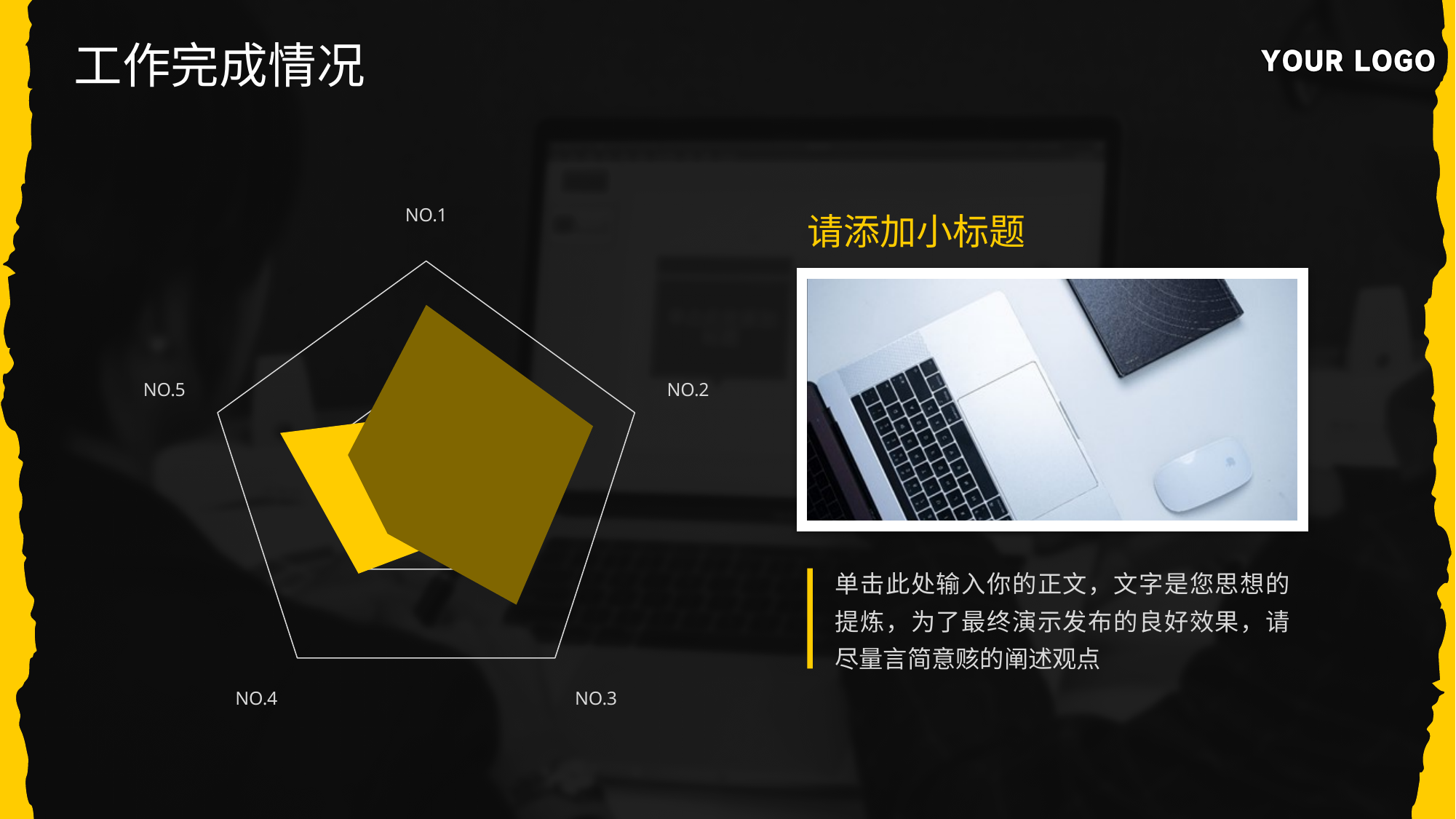
What kind of chart is shown on the left of the slide? radar chart How many categories (axes) does the radar chart have? 5 For the bright yellow series, which is larger: the value for NO.5 or the value for NO.1? NO.5 At category NO.2, which series has the larger value: the dark gold series or the bright yellow series? dark gold At category NO.1, which series has the larger value: the dark gold series or the bright yellow series? dark gold Which category label sits at the top of the radar chart? NO.1 How many filled data series are plotted on the radar chart? 2